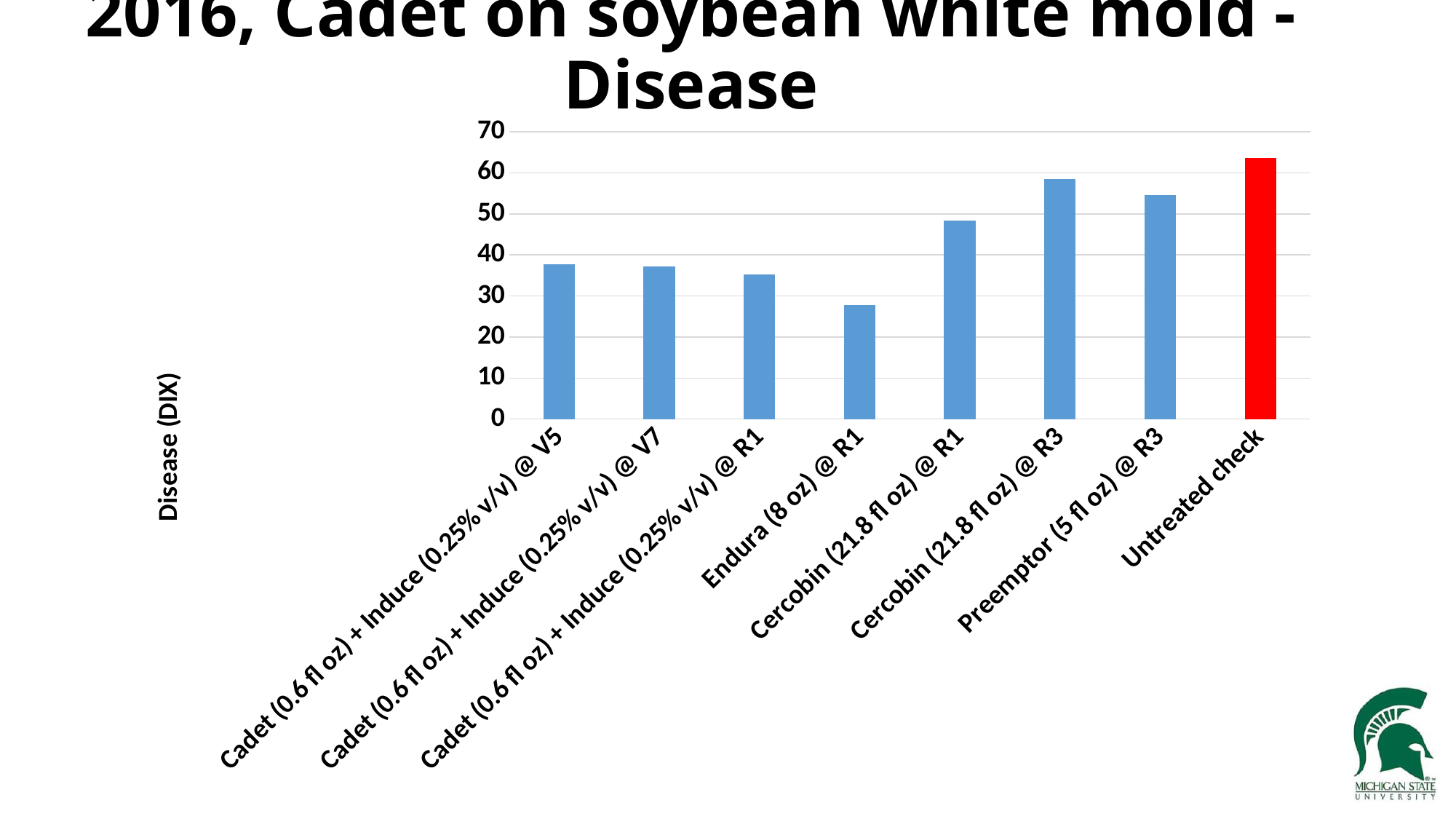
Is the value for Untreated check greater or less than 60? greater Which treatment has the lowest disease value? Endura (8 oz) @ R1 How many treatment categories are plotted on the chart? 8 Which has a higher disease value, Cercobin (21.8 fl oz) @ R3 or Cercobin (21.8 fl oz) @ R1? Cercobin (21.8 fl oz) @ R3 Is the value for Cadet (0.6 fl oz) + Induce (0.25% v/v) @ V5 greater or less than 40? less Is the value for Cercobin (21.8 fl oz) @ R1 greater or less than 40? greater Which has a lower disease value, Endura (8 oz) @ R1 or Preemptor (5 fl oz) @ R3? Endura (8 oz) @ R1 What kind of chart is shown on the slide? bar chart Which bar is coloured red on the chart? Untreated check What is the label on the vertical axis of the chart? Disease (DIX) Which treatment has the highest disease value? Untreated check